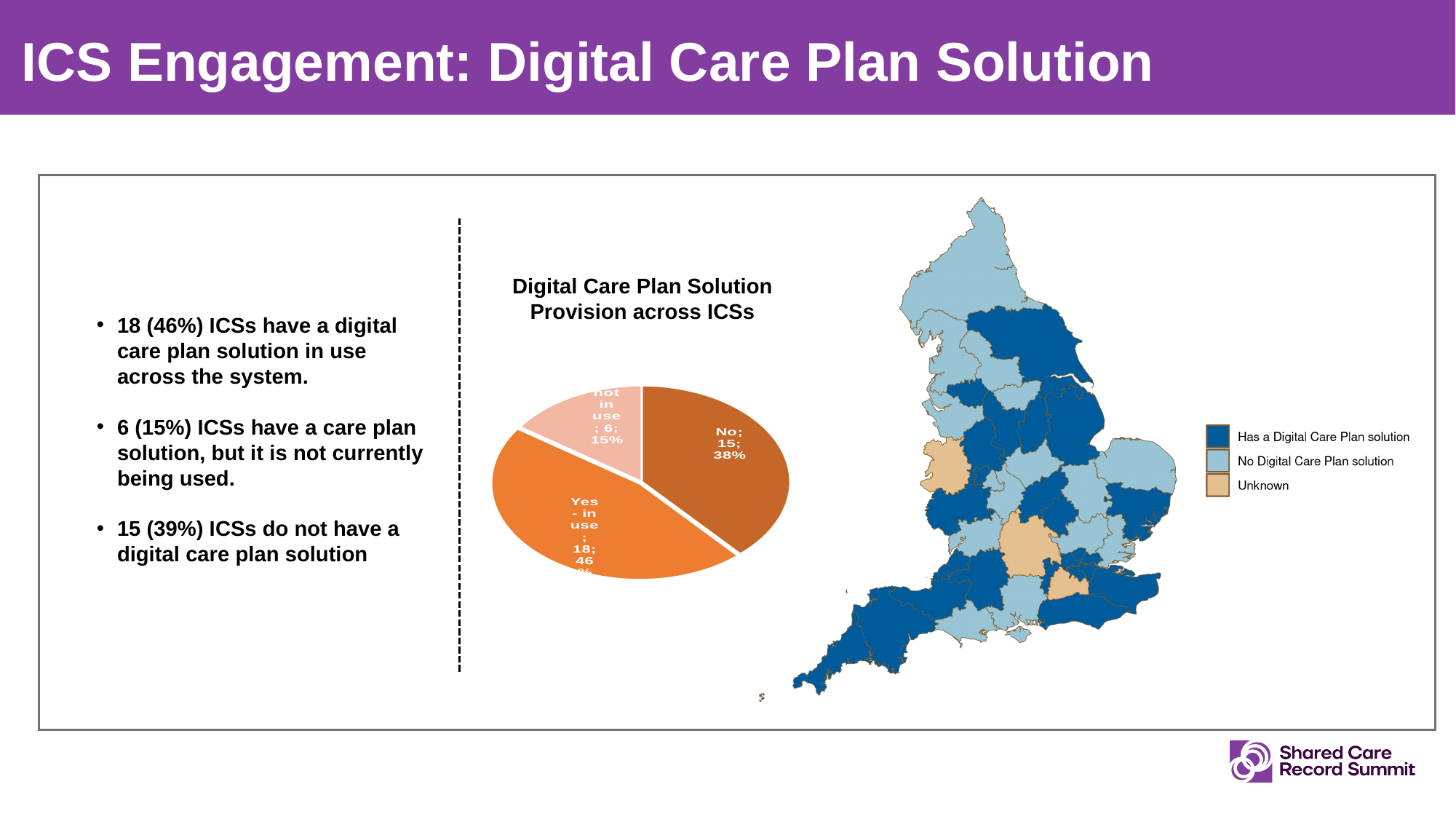
In the pie chart, what share of the pie is the 'not in use' slice? 15% Which slice of the pie chart is the largest? Yes - in use How many slices does the 'Digital Care Plan Solution Provision across ICSs' pie chart have? 3 What is the title of the pie chart on the slide? Digital Care Plan Solution Provision across ICSs In the pie chart, how many ICSs are in the 'No' slice? 15 In the pie chart, how many ICSs are in the 'Yes - in use' slice? 18 Which slice of the pie chart is the smallest? not in use In the pie chart, how many more ICSs are in the 'Yes - in use' slice than in the 'No' slice? 3 What kind of chart is 'Digital Care Plan Solution Provision across ICSs'? pie chart In the pie chart, how many ICSs are in the 'not in use' slice? 6 In the pie chart, what share of the pie is the 'No' slice? 38% In the pie chart, what share of the pie is the 'Yes - in use' slice? 46%